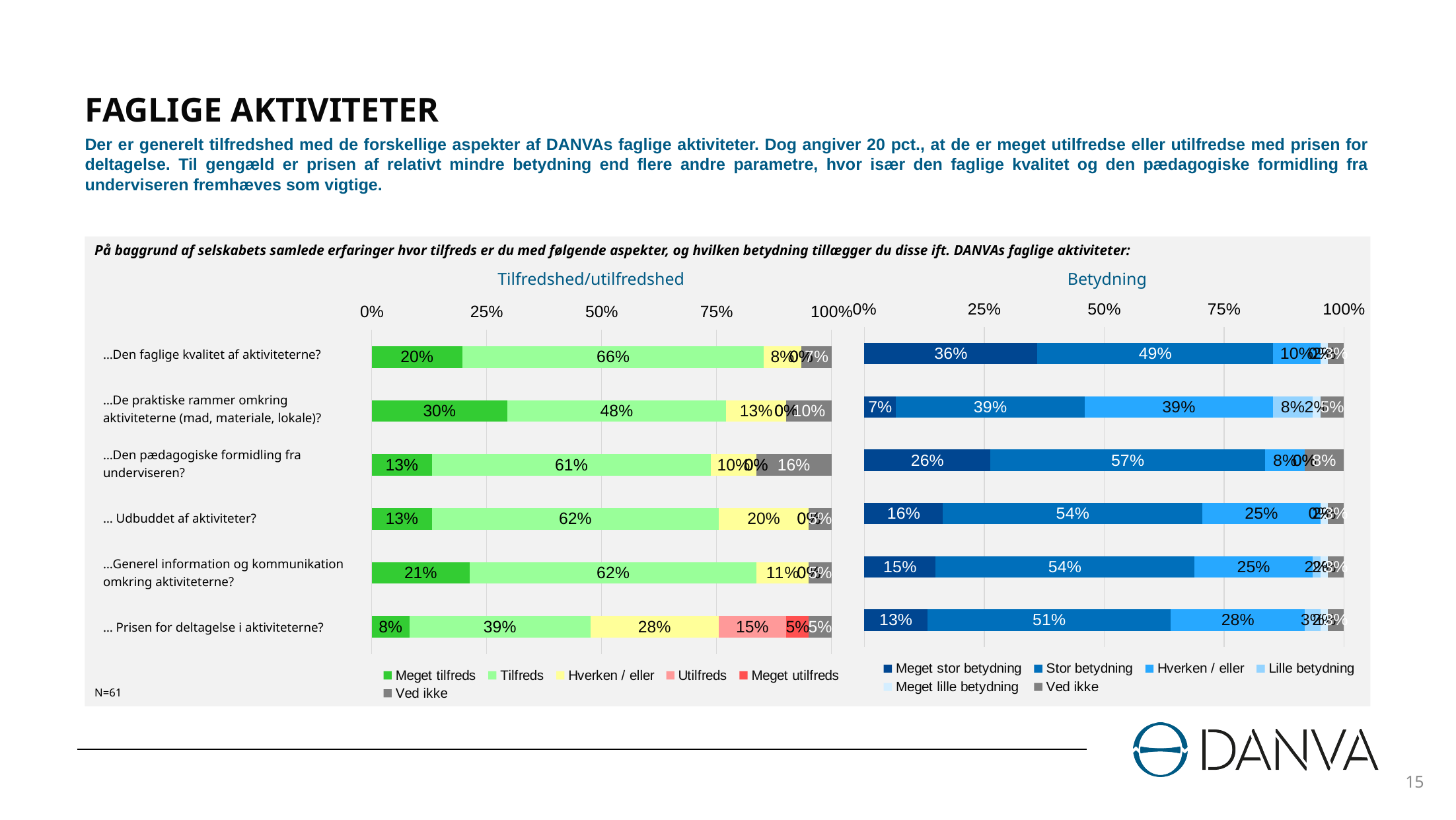
In the Tilfredshed/utilfredshed chart, what is the Utilfreds value for "Prisen for deltagelse i aktiviteterne"? 15% In the Betydning chart, which category has the highest Meget stor betydning value? Den faglige kvalitet af aktiviteterne In the Tilfredshed/utilfredshed chart, which category has the lowest Meget tilfreds value? Prisen for deltagelse i aktiviteterne How many series does the legend of the Betydning chart list? 6 In the Betydning chart, which is larger: the Meget stor betydning value for "Den pædagogiske formidling fra underviseren" or for "Udbuddet af aktiviteter"? Den pædagogiske formidling fra underviseren How many categories (aspects) are shown in the Tilfredshed/utilfredshed chart? 6 What type of chart is the Betydning chart? Stacked bar chart In the Betydning chart, what is the Stor betydning value for "Den pædagogiske formidling fra underviseren"? 57% In the Tilfredshed/utilfredshed chart, what share answered Meget tilfreds for "De praktiske rammer omkring aktiviteterne (mad, materiale, lokale)"? 30% What sample size (N) is stated on the slide? N=61 In the Tilfredshed/utilfredshed chart, what is the difference between the Tilfreds values for "Udbuddet af aktiviteter" and "Prisen for deltagelse i aktiviteterne"? 23% In the Tilfredshed/utilfredshed chart, what is the Tilfreds value for "Den faglige kvalitet af aktiviteterne"? 66%